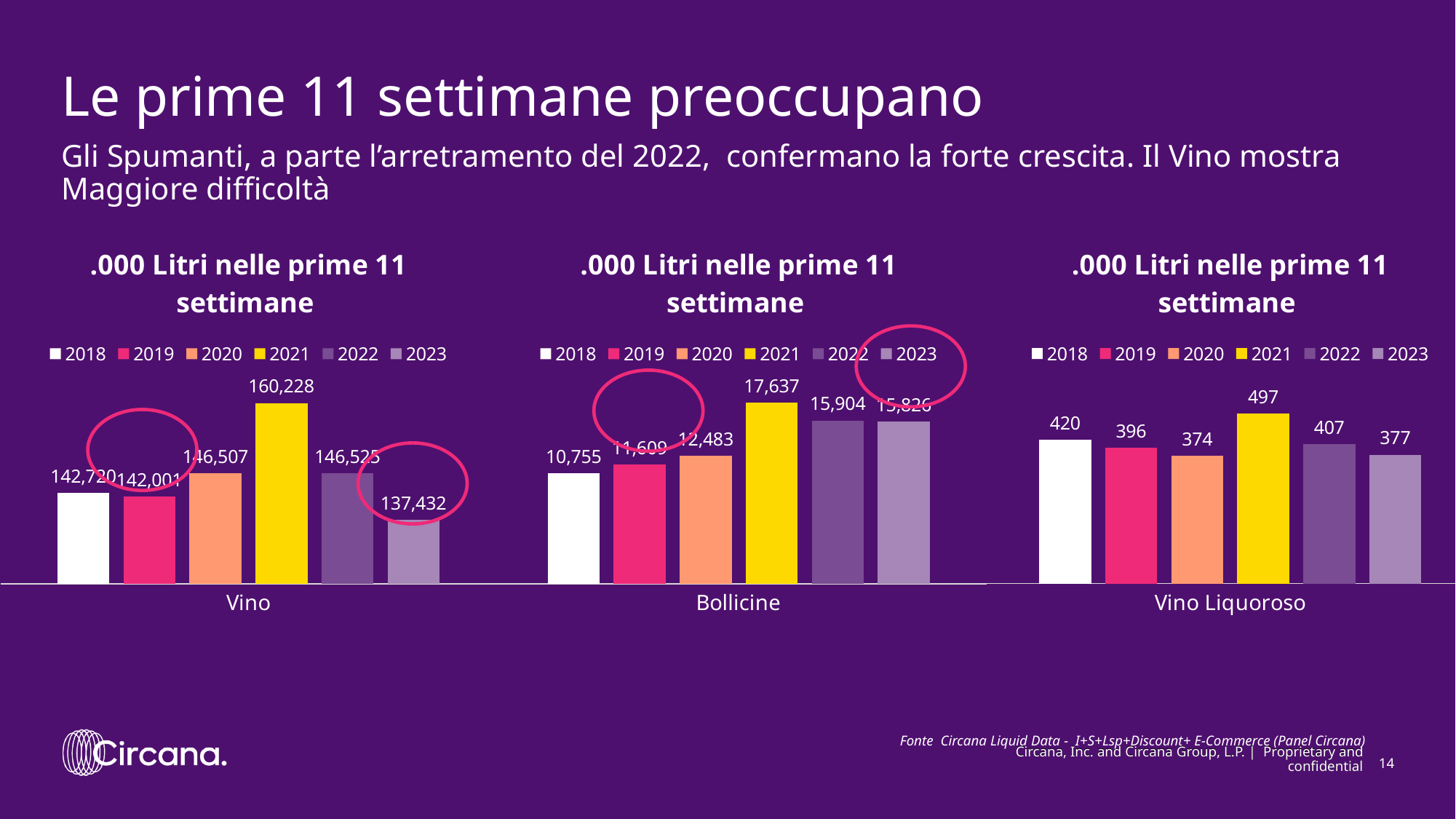
How many series does the legend of the right chart (Vino Liquoroso) list? 6 In the middle chart (Bollicine), what is the value for 2021? 17,637 In the right chart (Vino Liquoroso), what is the difference between the 2021 value and the 2020 value? 123 In the middle chart (Bollicine), what is the value for 2018? 10,755 In the left chart (Vino), which year has the lowest value? 2023 What kind of chart is the middle chart (Bollicine)? Bar chart In the middle chart (Bollicine), which year has the highest value? 2021 In the left chart (Vino), what is the value for 2023? 137,432 In the right chart (Vino Liquoroso), which is larger, the value for 2018 or the value for 2019? 2018 In the left chart (Vino), what is the difference between the 2021 value and the 2023 value? 22,796 In the right chart (Vino Liquoroso), what is the value for 2022? 407 In the left chart (Vino), what is the value for 2021? 160,228